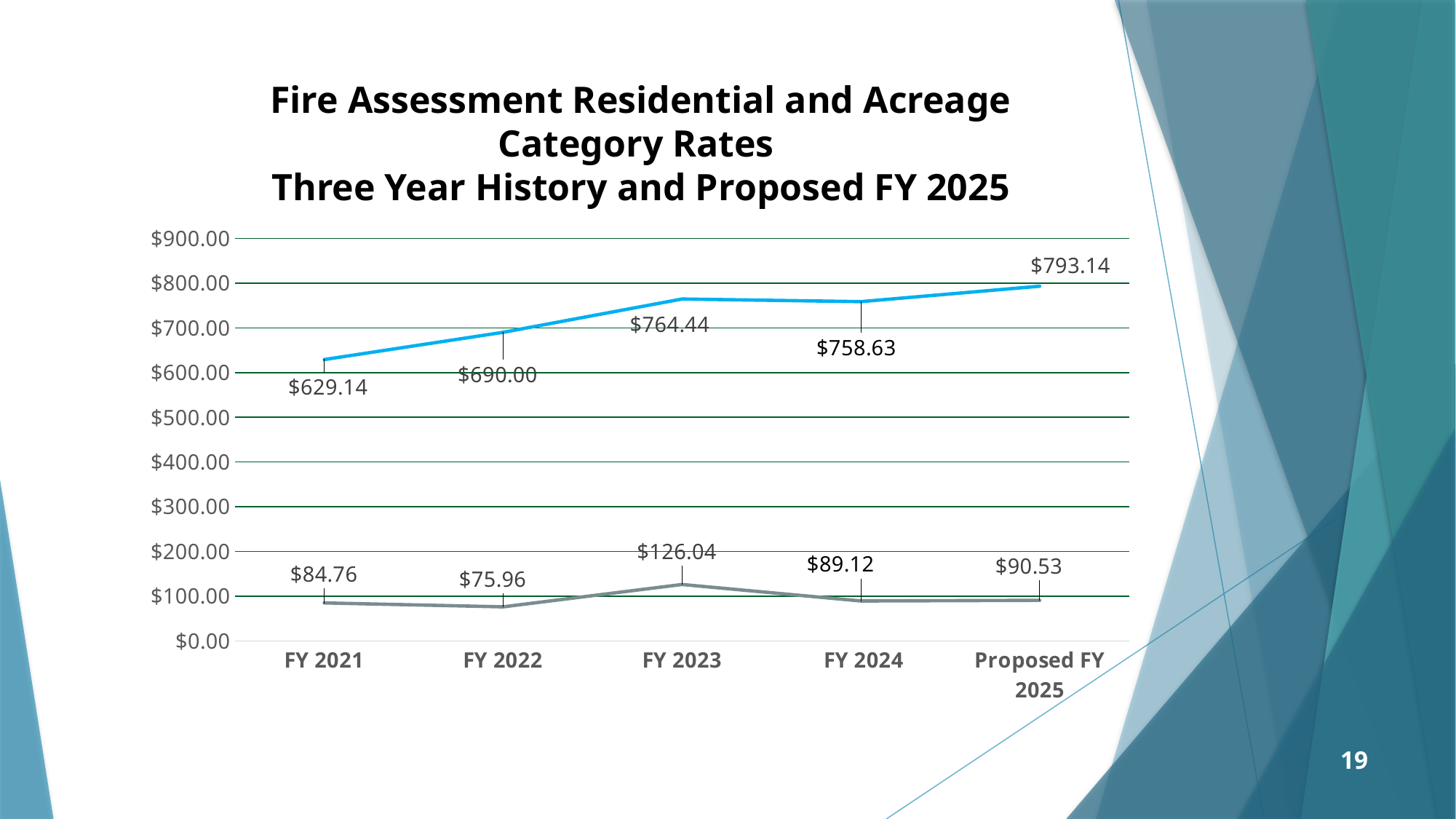
What is the difference between the gray line's FY 2023 and FY 2022 values? $50.08 What is the value of the gray line for FY 2024? $89.12 For the blue line, which is larger: the FY 2023 value or the FY 2024 value? FY 2023 How many fiscal year categories are shown on the x axis? 5 What kind of chart is shown on the slide? Line chart In which fiscal year does the blue line reach its highest value? Proposed FY 2025 What is the value of the blue line for Proposed FY 2025? $793.14 What is the value of the gray line for FY 2023? $126.04 Does the blue line generally rise or fall from FY 2021 to Proposed FY 2025? Rise By how much did the blue line increase from FY 2021 to FY 2022? $60.86 In which fiscal year does the gray line have its lowest value? FY 2022 What is the value of the blue line for FY 2021? $629.14